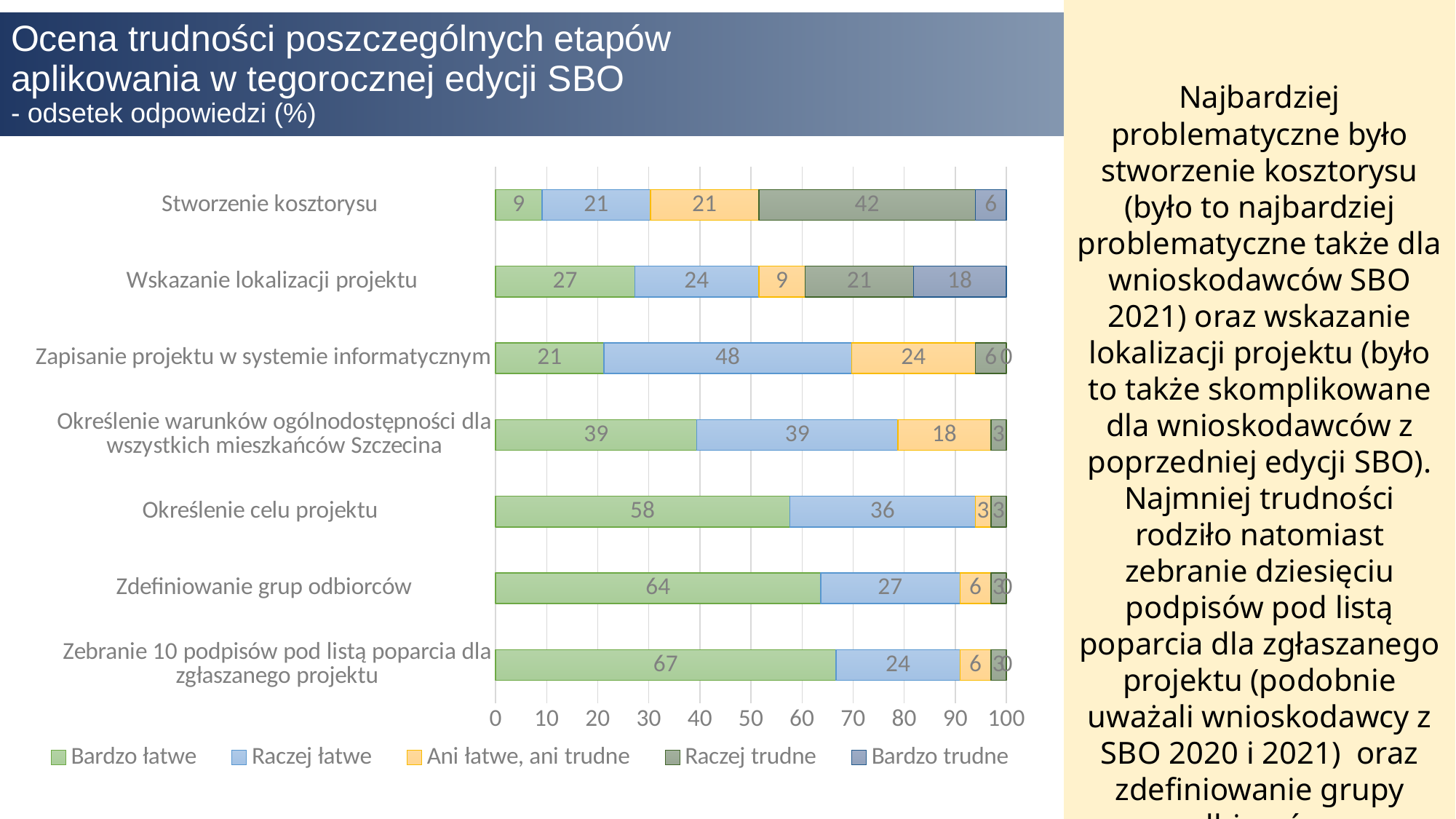
How many categories (application stages) are shown in the chart? 7 What percentage of respondents rated "Stworzenie kosztorysu" as "Raczej trudne"? 42 Which category has the lowest "Bardzo łatwe" value? Stworzenie kosztorysu What is the "Bardzo łatwe" value for "Zebranie 10 podpisów pod listą poparcia dla zgłaszanego projektu"? 67 How many series does the legend list? 5 What is the first entry in the chart legend? Bardzo łatwe Which category has the highest "Bardzo łatwe" value? Zebranie 10 podpisów pod listą poparcia dla zgłaszanego projektu What is the "Raczej łatwe" value for "Zapisanie projektu w systemie informatycznym"? 48 What is the "Bardzo trudne" value for "Wskazanie lokalizacji projektu"? 18 What type of chart is shown on the slide? Stacked bar chart What is the difference between the "Bardzo łatwe" values for "Zebranie 10 podpisów pod listą poparcia dla zgłaszanego projektu" and "Zdefiniowanie grup odbiorców"? 3 Which has a larger "Raczej trudne" value: "Stworzenie kosztorysu" or "Wskazanie lokalizacji projektu"? Stworzenie kosztorysu